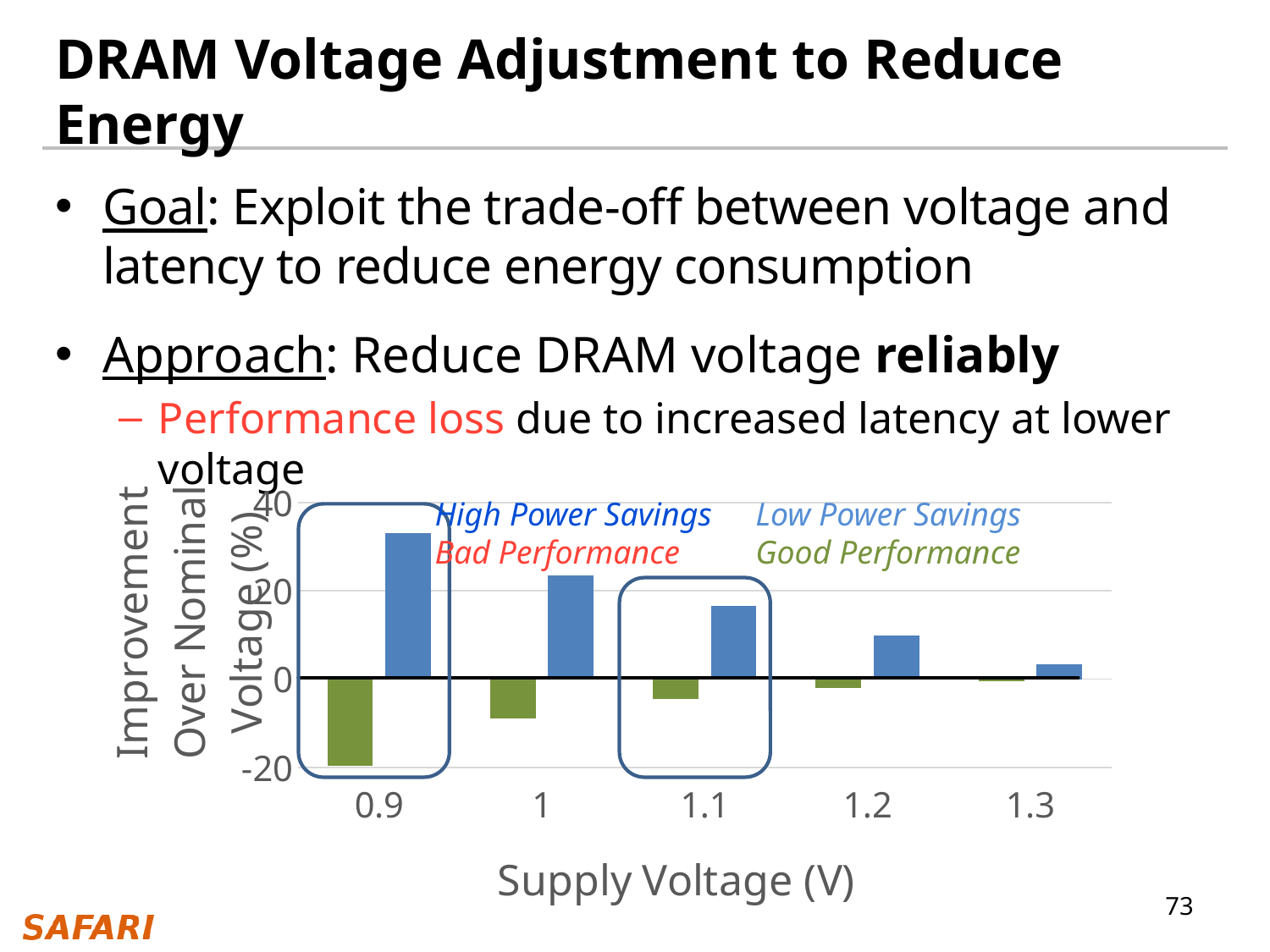
How many supply voltage categories are shown on the x axis? 5 Is the blue bar at 0.9 V greater or less than 20? greater At which supply voltage is the blue bar the tallest? 0.9 At which supply voltage is the blue bar the shortest? 1.3 Is the blue bar at 1.3 V greater or less than 20? less Do the blue bars rise or fall as supply voltage increases from 0.9 to 1.3? fall What is the title of the x axis? Supply Voltage (V) What kind of chart is shown on the slide? bar chart Which supply voltage has the most negative green bar? 0.9 Is the blue bar at 1.1 V greater or less than 20? less Which is larger, the blue bar at 0.9 V or the blue bar at 1.2 V? 0.9 V